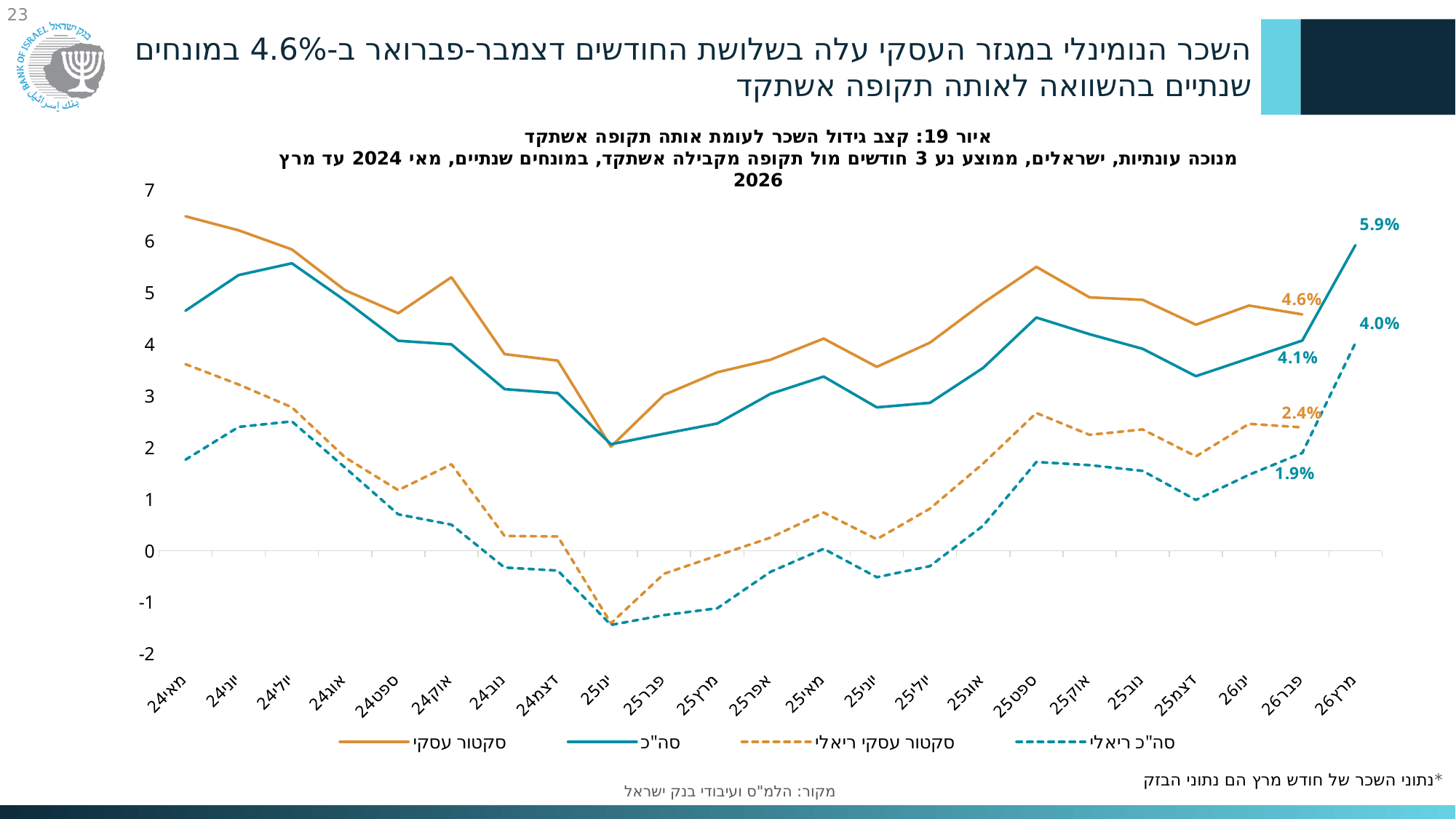
What is the value of the סקטור עסקי series at פבר26? 4.6% By how much did the סה"כ series rise from פבר26 (4.1%) to מרץ26 (5.9%)? 1.8 percentage points How many series does the legend list? 4 What is the value of the סקטור עסקי ריאלי series at פבר26? 2.4% What is the value of the סה"כ series at מרץ26? 5.9% In which month does the סקטור עסקי series reach its lowest value? ינו25 What type of chart is shown on the slide? line chart What is the value of the סה"כ ריאלי series at מרץ26? 4.0% At פבר26, which is larger: סקטור עסקי or סה"כ? סקטור עסקי Is the value of the סקטור עסקי series at מאי24 greater or less than 6? greater How many months are shown along the x axis? 23 Is the value of the סה"כ ריאלי series at ינו25 greater or less than -1? less